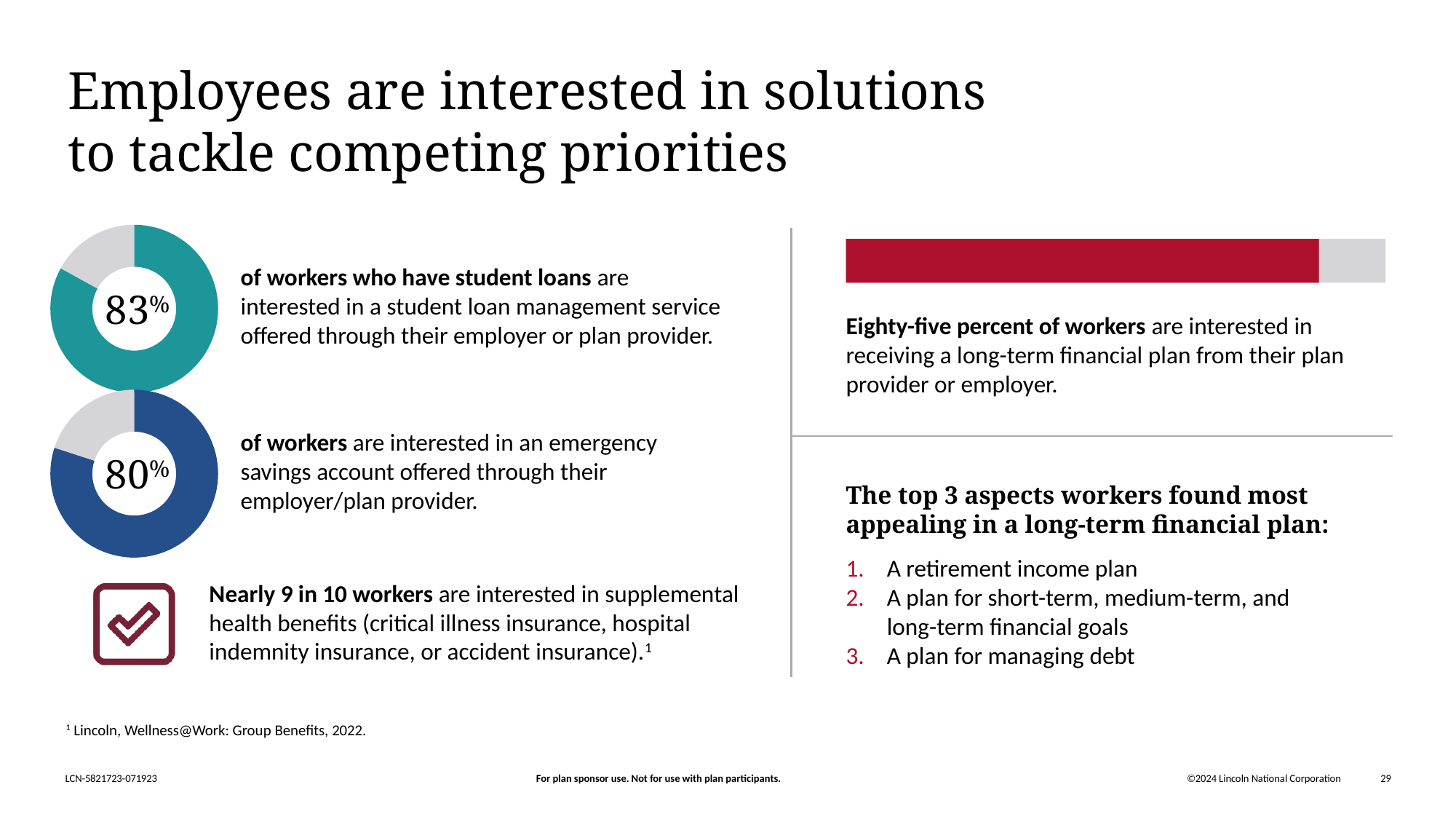
What percentage is shown in the top (teal) donut chart about workers who have student loans? 83% How many donut charts are on the slide? 2 What is the difference between the values shown in the two donut charts? 3 percentage points Which of the two donut charts shows the larger value, the student loan management service one or the emergency savings account one? The student loan management service one (83%) What percentage is shown in the bottom (blue) donut chart about workers interested in an emergency savings account? 80% Is the value in the bottom donut chart greater or less than 50%? greater What colour is the filled portion of the top donut chart showing 83%? Teal In the bottom donut chart, what share of the ring is left unfilled (grey)? 20% In the top donut chart, what share of the ring is left unfilled (grey)? 17% What kind of chart is used to show the 83% and 80% figures on the left of the slide? Donut (pie) chart What colour is the filled portion of the horizontal bar on the right side of the slide? Dark red